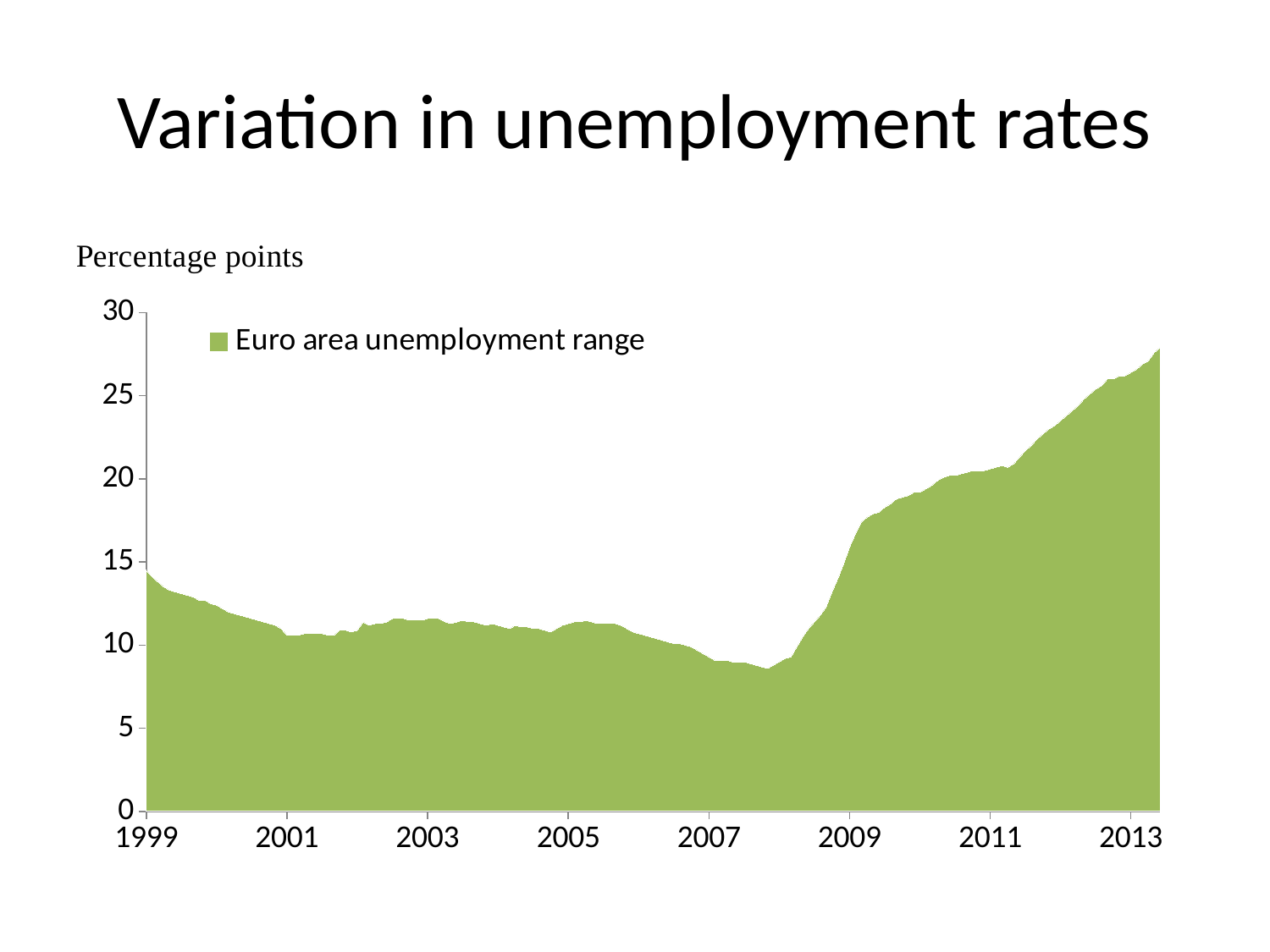
What is the title of the chart? Variation in unemployment rates What series name is shown in the legend? Euro area unemployment range What kind of chart is shown on the slide? Area chart Is the value for 2011 greater or less than 20? greater How many series does the legend list? 1 Which labelled year on the x axis has the highest value? 2013 Is the value for 2003 greater or less than 15? less Is the value for 1999 greater or less than 10? greater Do the values rise or fall between 2009 and 2013? rise Which year has the larger value, 2007 or 2013? 2013